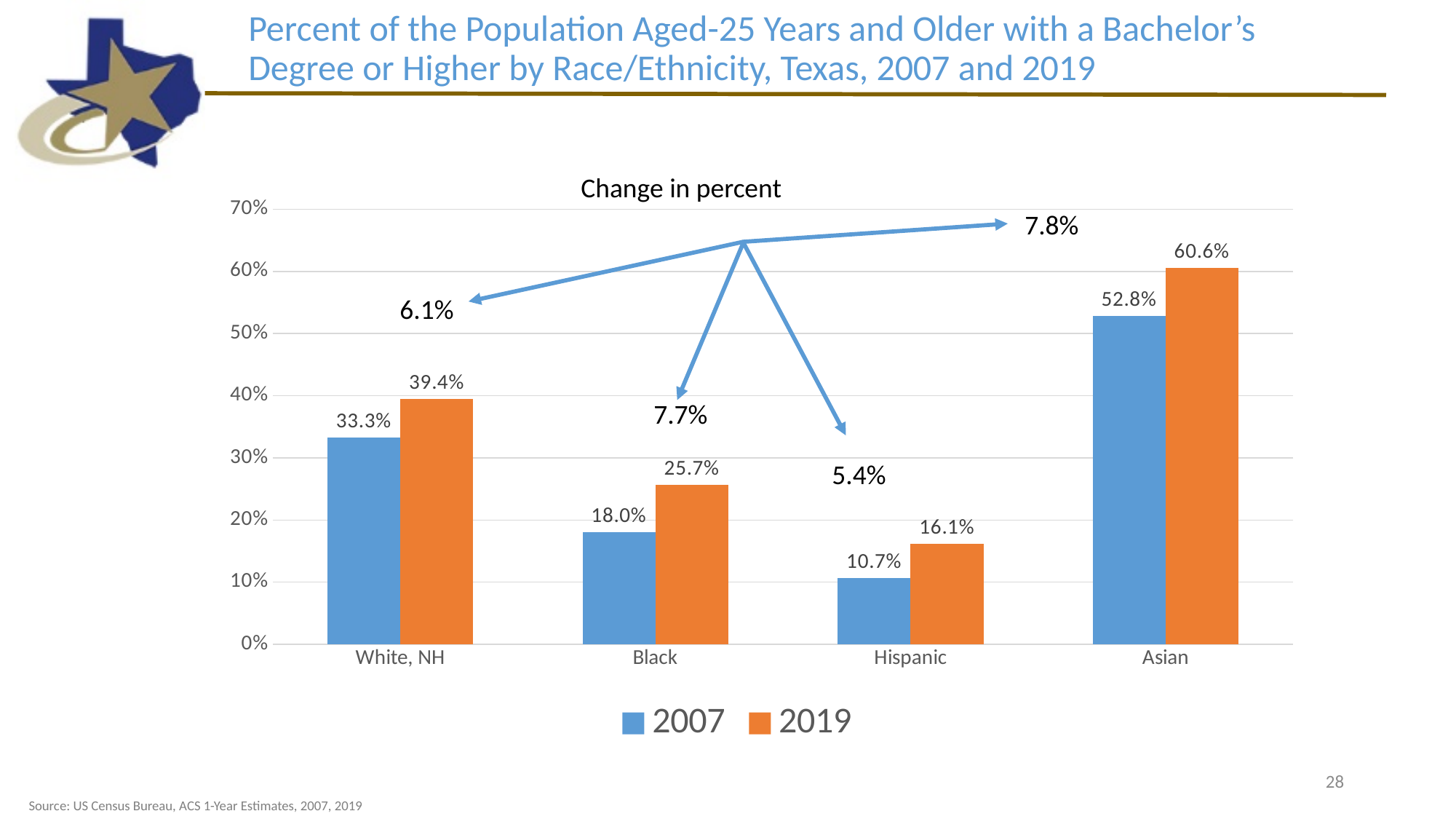
What was the value for Black Texans in 2019? 25.7% What is the difference between the 2019 and 2007 values for White, NH? 6.1% Which race/ethnicity group had the highest percent with a bachelor's degree or higher in 2019? Asian What was the value for Asian Texans in 2019? 60.6% Which race/ethnicity group had the lowest percent with a bachelor's degree or higher in 2007? Hispanic How many race/ethnicity categories are shown on the x axis? 4 What change in percent is annotated for the Hispanic group? 5.4% How many series does the legend list? 2 What kind of chart is shown on the slide? Bar chart What was the percent of the population aged 25 and older with a bachelor's degree or higher for Hispanic Texans in 2007? 10.7% Is the 2007 value for Asian greater or less than 50%? greater Which is larger: the 2019 value for Black or the 2007 value for White, NH? 2007 value for White, NH